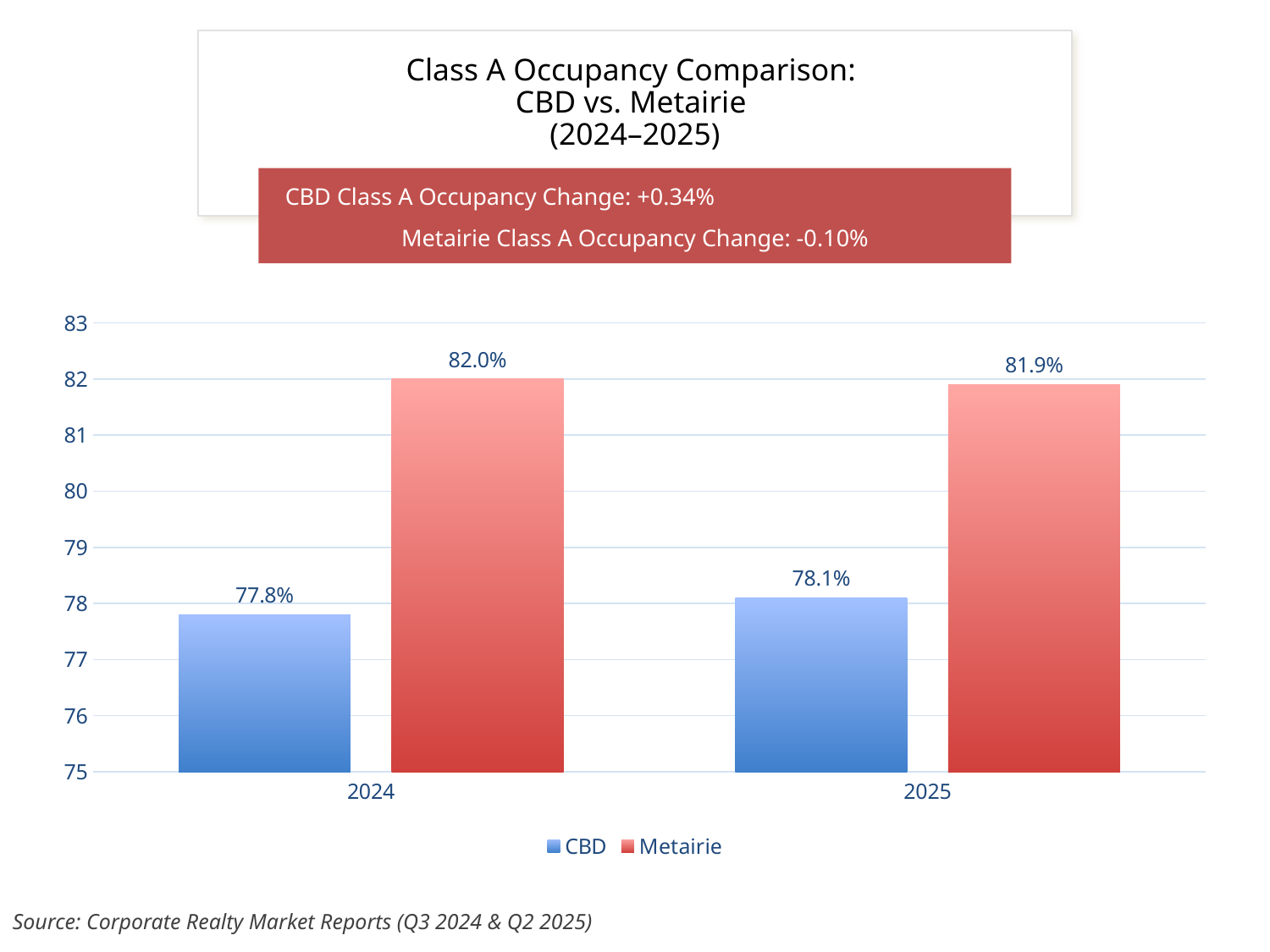
What kind of chart is shown on the slide? bar chart What is the CBD value for 2025? 78.1% How many series does the legend list? 2 Does the CBD series rise or fall from 2024 to 2025? rise What is the Metairie value for 2024? 82.0% What is the Metairie Class A occupancy value for 2025? 81.9% Does the Metairie series rise or fall from 2024 to 2025? fall What is the CBD Class A occupancy value for 2024? 77.8% What is the difference between the CBD values for 2025 and 2024? 0.3% Which series has the higher occupancy in 2025, CBD or Metairie? Metairie How many year categories are shown on the x axis? 2 What is the difference between the Metairie and CBD values in 2024? 4.2%